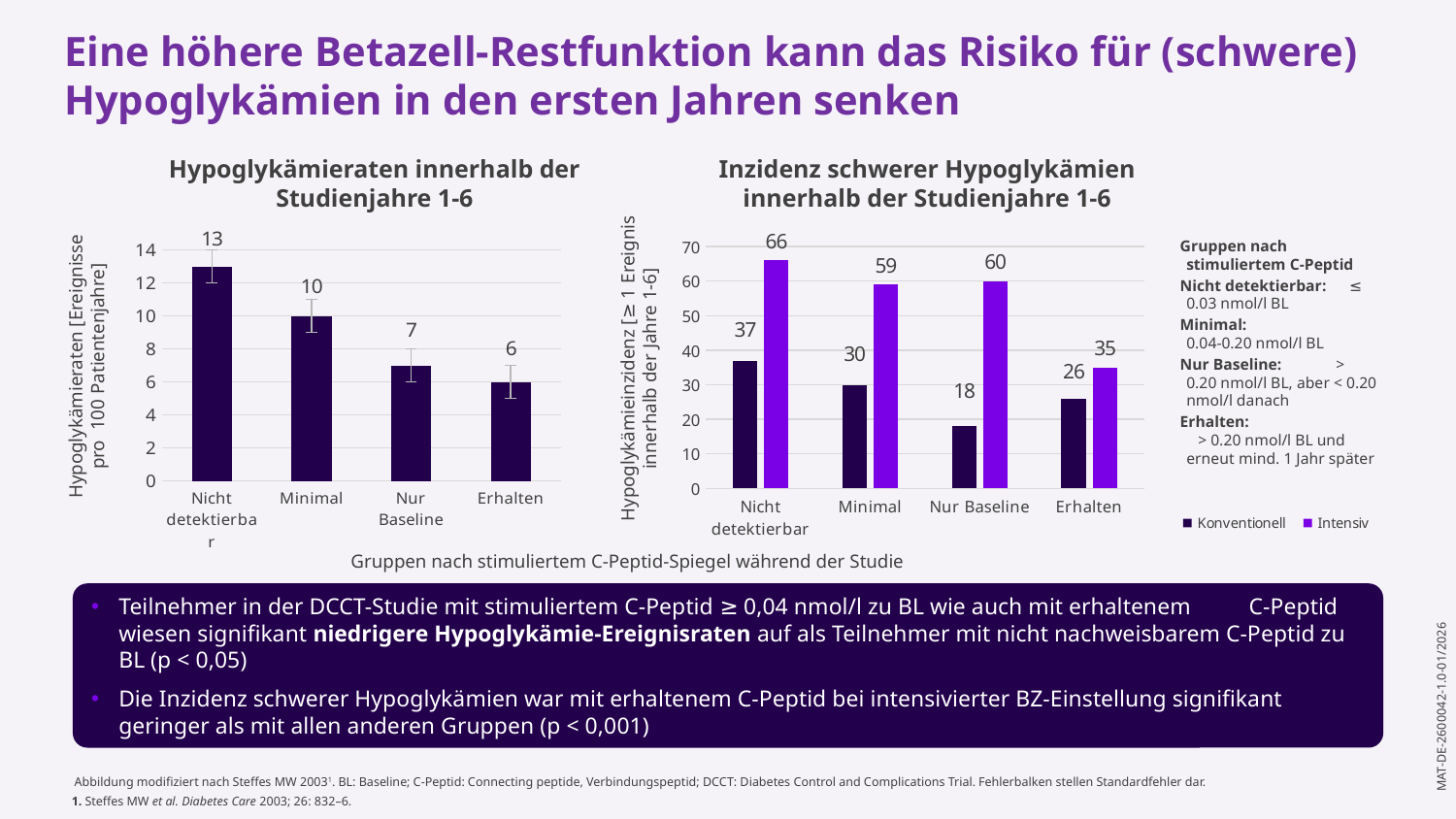
In the chart 'Hypoglykämieraten innerhalb der Studienjahre 1-6', do the values rise or fall from left to right along the x axis? fall In the chart 'Inzidenz schwerer Hypoglykämien innerhalb der Studienjahre 1-6', what is the Intensiv value for 'Minimal'? 59 In the chart 'Hypoglykämieraten innerhalb der Studienjahre 1-6', what is the value for 'Nicht detektierbar'? 13 In the chart 'Hypoglykämieraten innerhalb der Studienjahre 1-6', what is the difference between the values for 'Nicht detektierbar' and 'Nur Baseline'? 6 How many series does the legend list in the chart 'Inzidenz schwerer Hypoglykämien innerhalb der Studienjahre 1-6'? 2 What type of chart is 'Inzidenz schwerer Hypoglykämien innerhalb der Studienjahre 1-6'? bar chart How many categories are shown in the chart 'Hypoglykämieraten innerhalb der Studienjahre 1-6'? 4 In the chart 'Hypoglykämieraten innerhalb der Studienjahre 1-6', which category has the lowest value? Erhalten In the chart 'Inzidenz schwerer Hypoglykämien innerhalb der Studienjahre 1-6', which category has the highest Intensiv value? Nicht detektierbar In the chart 'Inzidenz schwerer Hypoglykämien innerhalb der Studienjahre 1-6', which is larger for 'Nicht detektierbar': the Konventionell value or the Intensiv value? Intensiv In the chart 'Inzidenz schwerer Hypoglykämien innerhalb der Studienjahre 1-6', what is the Konventionell value for 'Nur Baseline'? 18 In the chart 'Inzidenz schwerer Hypoglykämien innerhalb der Studienjahre 1-6', what is the difference between the Intensiv and Konventionell values for 'Erhalten'? 9